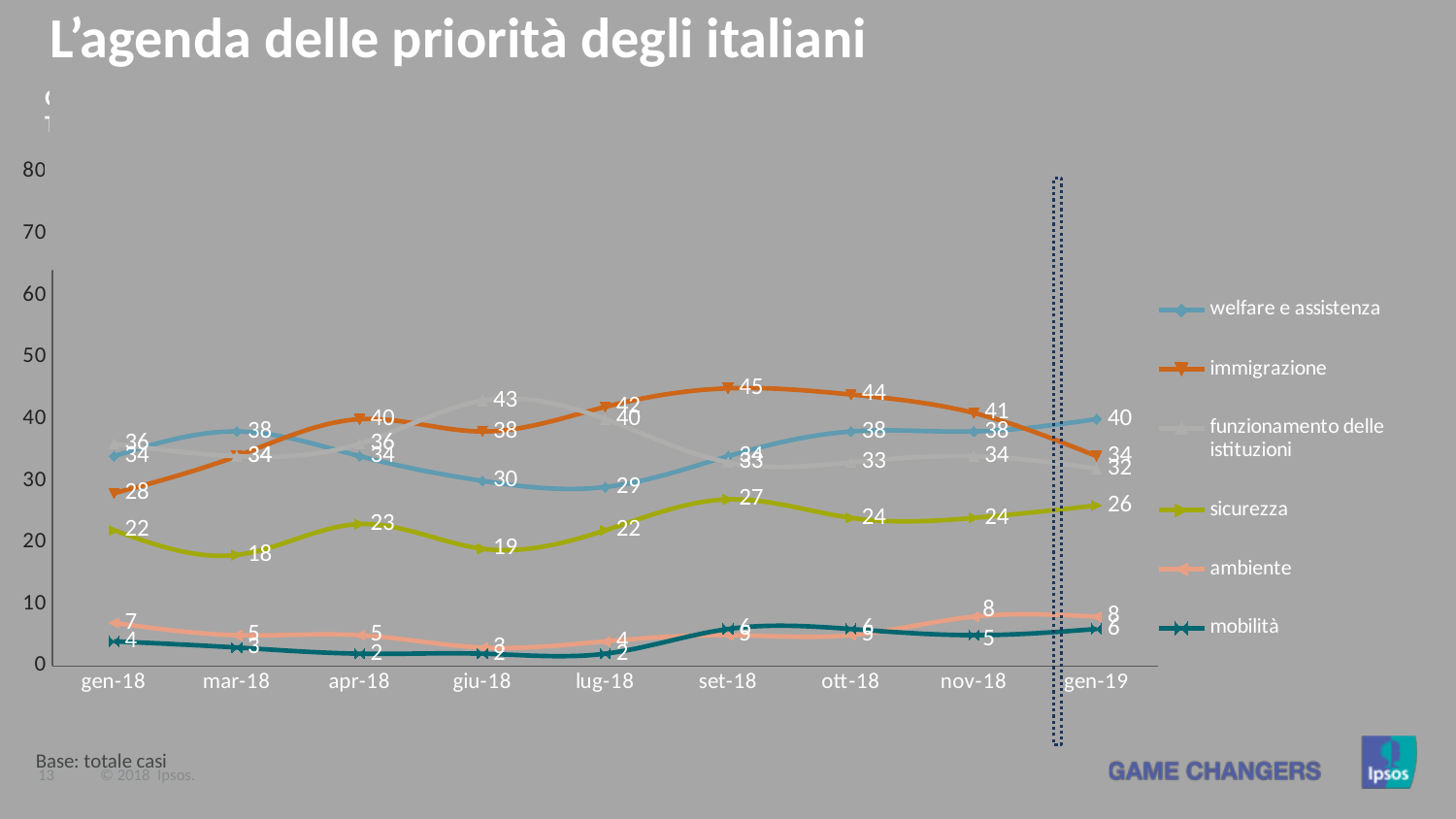
Is the value for sicurezza in set-18 greater or less than 20? greater What is the value for immigrazione in set-18? 45 How many time points are shown on the x axis? 9 What is the value for sicurezza in mar-18? 18 What is the difference between the immigrazione value in set-18 and in gen-18? 17 How many series does the legend list? 6 What is the value for funzionamento delle istituzioni in giu-18? 43 In which month does sicurezza reach its lowest value? mar-18 In which month does immigrazione reach its highest value? set-18 In giu-18, which is higher: funzionamento delle istituzioni or immigrazione? funzionamento delle istituzioni What is the value for welfare e assistenza in gen-19? 40 What kind of chart is shown on the slide? line chart